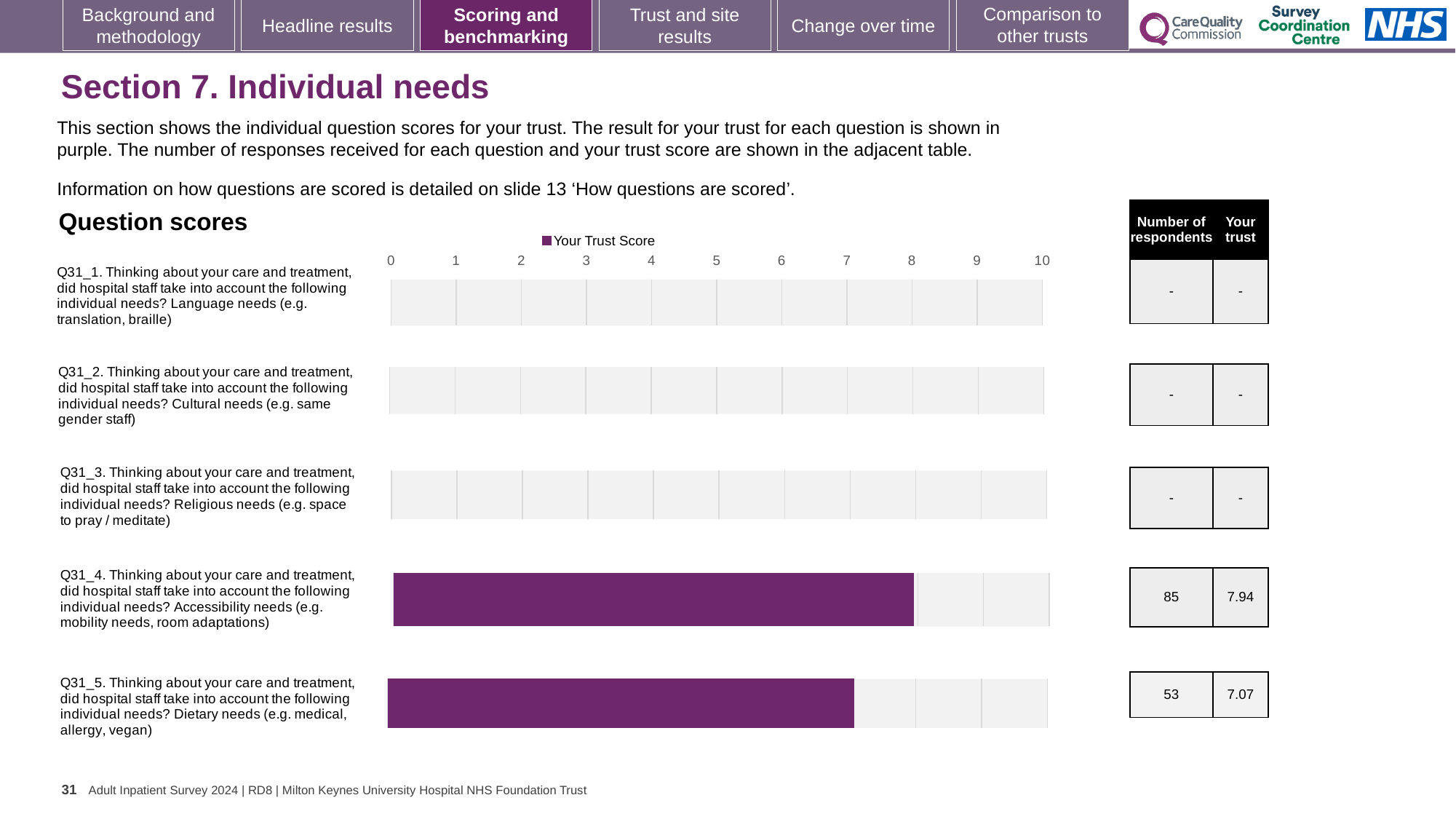
What is the trust score for Q31_4 (Accessibility needs)? 7.94 What is the difference between the trust scores for Q31_4 (Accessibility needs) and Q31_5 (Dietary needs)? 0.87 How many respondents answered Q31_4 (Accessibility needs)? 85 How many series does the legend list for the question score charts? 1 What is the trust score for Q31_5 (Dietary needs)? 7.07 Is the trust score for Q31_4 (Accessibility needs) greater or less than 7? greater Is the trust score for Q31_5 (Dietary needs) greater or less than 8? less What type of chart is used to show the question scores on this slide? Bar chart What is the name of the series shown in the legend of the question score charts? Your Trust Score Which question has the higher trust score, Q31_4 (Accessibility needs) or Q31_5 (Dietary needs)? Q31_4 How many respondents answered Q31_5 (Dietary needs)? 53 How many questions (Q31_1 to Q31_5) have a trust score shown as a bar on this slide? 2